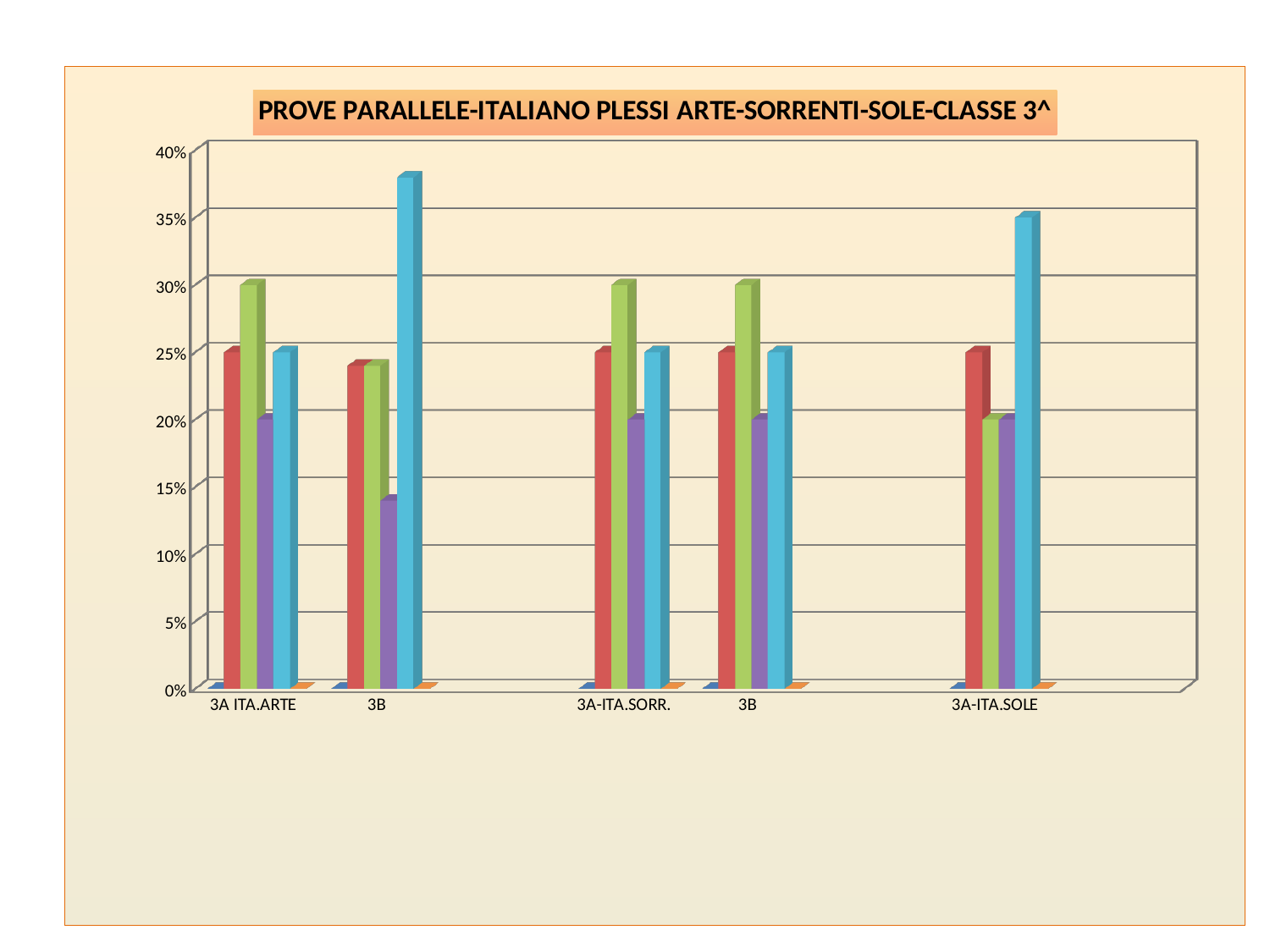
Is the shortest bar in the 3A-ITA.SOLE category greater or less than 25%? less Which category contains the tallest bar in the whole chart? 3B (second category from the left) Is the tallest bar in the 3B category second from the left greater or less than 35%? greater What is the title of the chart? PROVE PARALLELE-ITALIANO PLESSI ARTE-SORRENTI-SOLE-CLASSE 3^ Which is taller: the tallest bar in the 3B category second from the left, or the tallest bar in the 3A-ITA.SOLE category? 3B (second from the left) What kind of chart is shown on the slide? bar chart Is the shortest bar in the 3B category second from the left greater or less than 15%? less How many categories are labelled on the x axis of the chart? 5 What is the highest value shown on the vertical axis of the chart? 40%